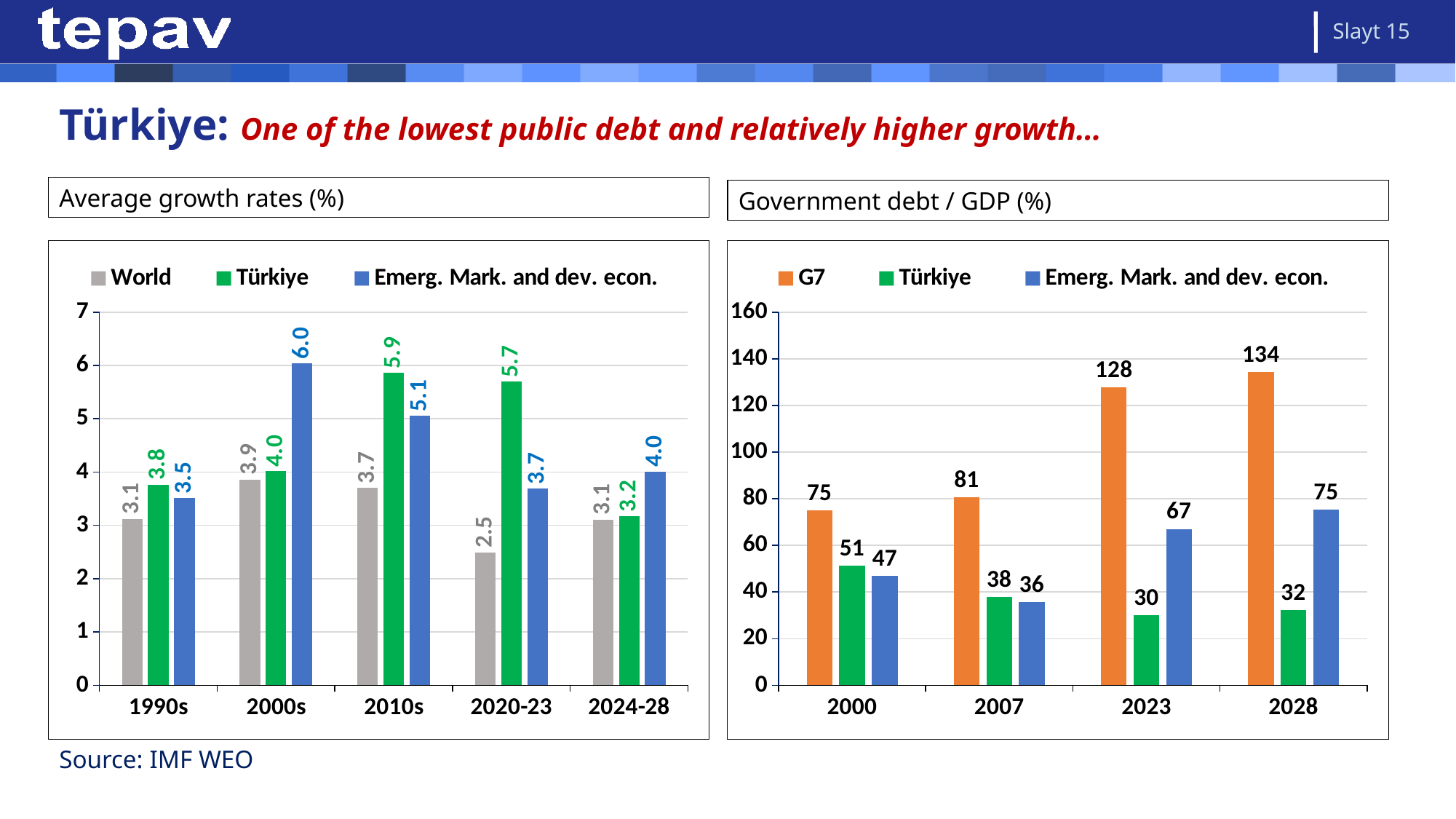
In the 'Average growth rates (%)' chart, what is the value for Türkiye in the 2010s? 5.9 What kind of chart is the 'Government debt / GDP (%)' chart? bar chart In the 'Government debt / GDP (%)' chart, which year has the lowest value for Türkiye? 2023 In the 'Government debt / GDP (%)' chart, is the value for Türkiye in 2000 larger or smaller than the value for Emerg. Mark. and dev. econ. in 2000? larger In the 'Government debt / GDP (%)' chart, what is the difference between G7 and Emerg. Mark. and dev. econ. in 2023? 61 In the 'Average growth rates (%)' chart, how many periods are shown on the x axis? 5 In the 'Average growth rates (%)' chart, which period has the highest value for Emerg. Mark. and dev. econ.? 2000s In the 'Average growth rates (%)' chart, what is the value for World in 2020-23? 2.5 In the 'Government debt / GDP (%)' chart, what is the value for Türkiye in 2023? 30 In the 'Government debt / GDP (%)' chart, what is the value for G7 in 2028? 134 In the 'Average growth rates (%)' chart, how many series does the legend list? 3 In the 'Average growth rates (%)' chart, what is the difference between Türkiye and World in the 2020-23 period? 3.2